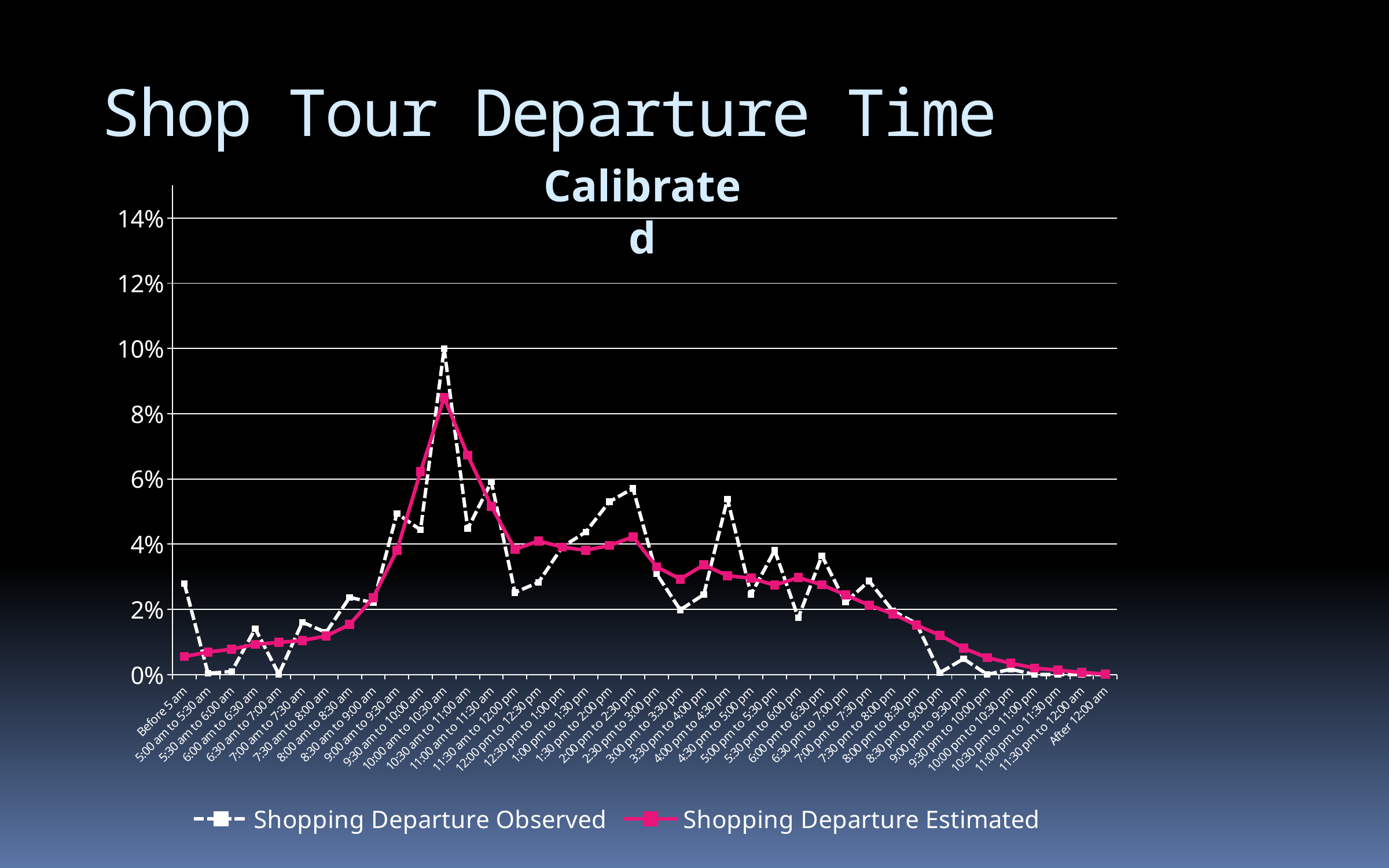
How many series does the legend list? 2 Does the Shopping Departure Estimated line rise or fall from 8:00 pm to 8:30 pm through After 12:00 am? fall Is the Shopping Departure Estimated value for 10:00 am to 10:30 am greater or less than 8%? greater What kind of chart is shown on the slide? line chart Is the Shopping Departure Observed value for 2:00 pm to 2:30 pm greater or less than 6%? less Is the Shopping Departure Observed value for 4:00 pm to 4:30 pm greater or less than 4%? greater What is the Shopping Departure Observed value for 10:00 am to 10:30 am? 10% At 11:30 am to 12:00 pm, which series has the larger value, Shopping Departure Observed or Shopping Departure Estimated? Shopping Departure Estimated Which time period has the highest Shopping Departure Estimated value? 10:00 am to 10:30 am Which series is drawn with a dashed white line? Shopping Departure Observed Which time period has the highest Shopping Departure Observed value? 10:00 am to 10:30 am What is the title of the chart? Calibrated